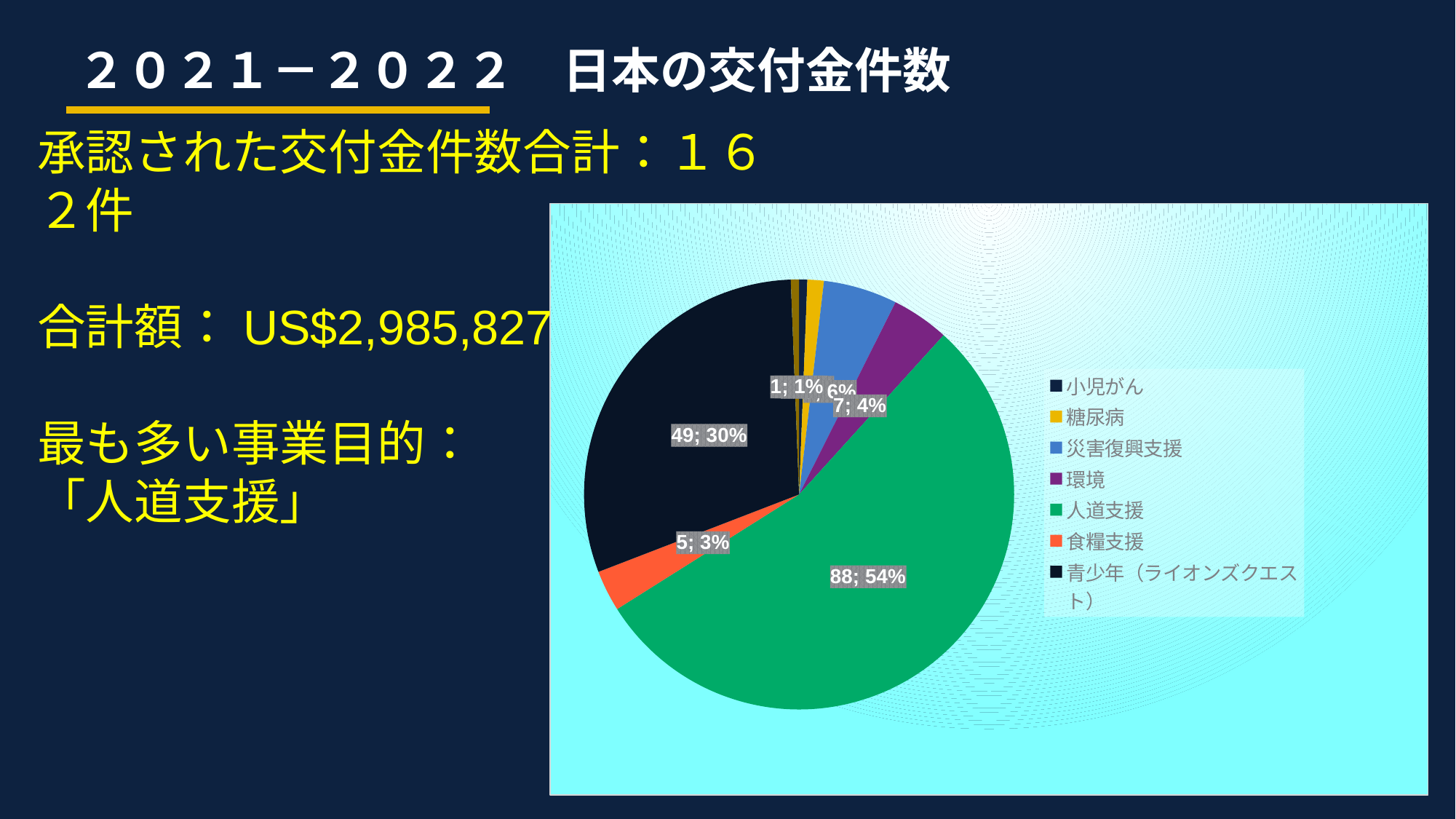
What kind of chart is shown on the slide? pie chart Which is larger in the pie chart, 環境 or 食糧支援? 環境 What is the data label shown for 環境 in the pie chart? 7; 4% What is the data label shown for 青少年（ライオンズクエスト） in the pie chart? 49; 30% Which category has the largest slice of the pie chart? 人道支援 What is the difference between the counts for 人道支援 (88) and 青少年（ライオンズクエスト） (49)? 39 Which is larger in the pie chart, 人道支援 or 青少年（ライオンズクエスト）? 人道支援 What share of the pie does 青少年（ライオンズクエスト） account for? 30% What is the data label shown for 食糧支援 in the pie chart? 5; 3% What share of the pie does 人道支援 account for? 54% How many categories does the legend of the pie chart list? 7 What is the data label shown for 人道支援 in the pie chart? 88; 54%